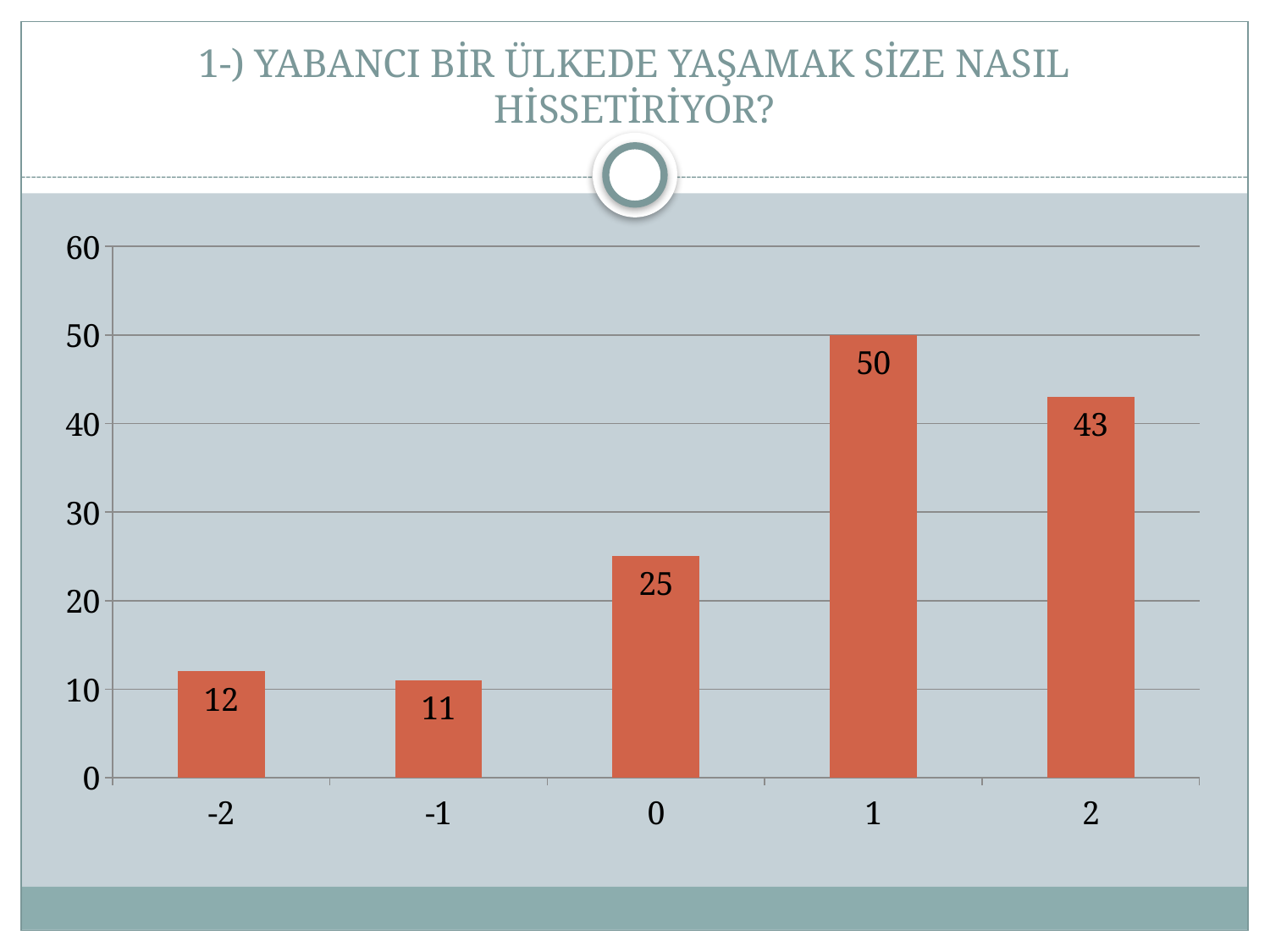
What is the value for category 1? 50 What kind of chart is shown on the slide? bar chart What is the title of the slide containing the chart? 1-) YABANCI BİR ÜLKEDE YAŞAMAK SİZE NASIL HİSSETİRİYOR? How many categories are shown on the x axis? 5 Which category has the lowest value? -1 Which category has the highest value? 1 What is the value for category 0? 25 What is the value for category -2? 12 Which is larger, the value for category 2 or the value for category 0? 2 Is the value for category 2 greater or less than 40? greater What is the difference between the values for category 1 and category 2? 7 What is the difference between the values for category 0 and category -2? 13